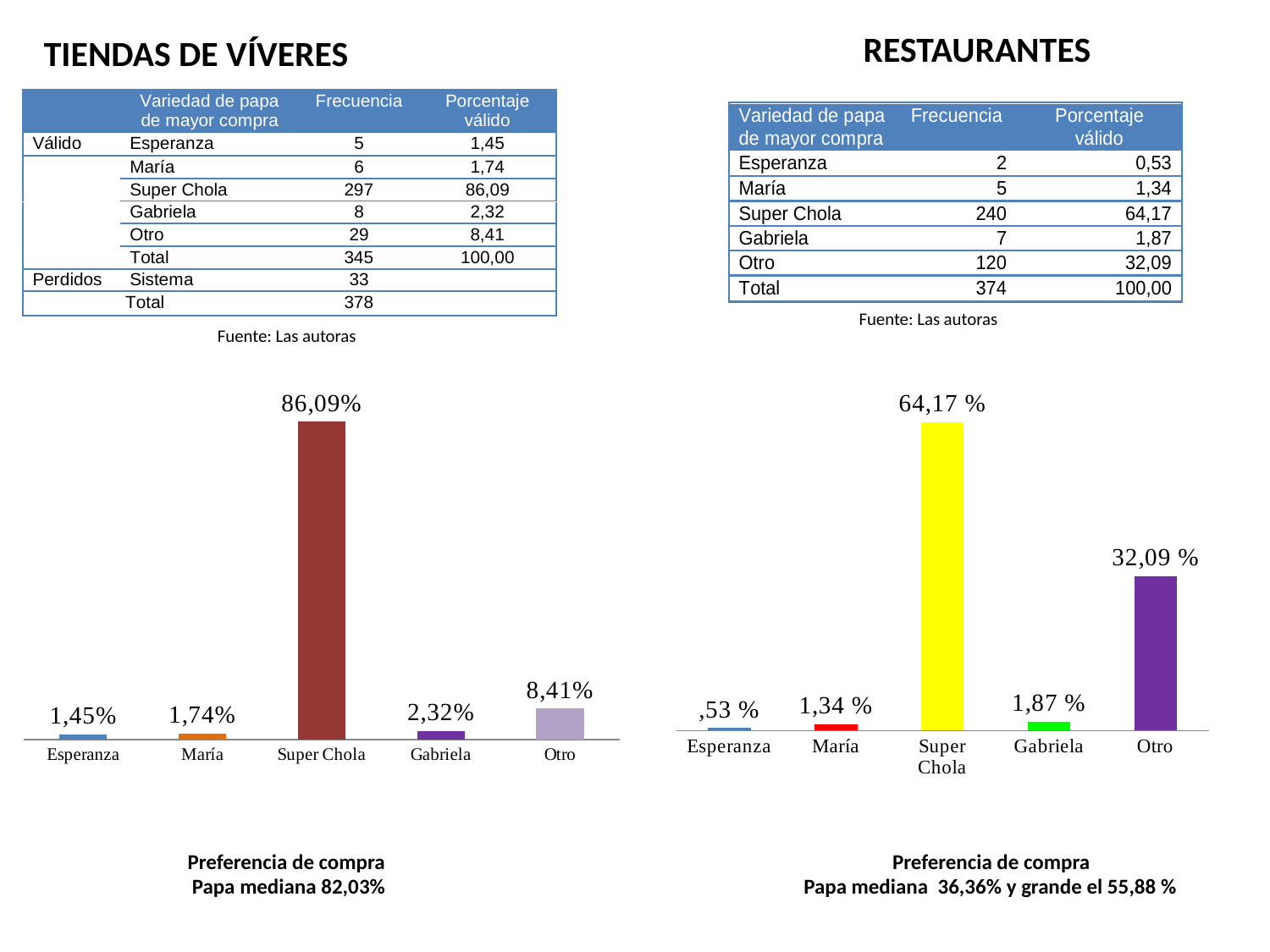
In the chart under TIENDAS DE VÍVERES (left), what is the value for Super Chola? 86,09% In the chart under RESTAURANTES (right), what is the value for Gabriela? 1,87 % In the chart under TIENDAS DE VÍVERES (left), which category has the lowest value? Esperanza What kind of chart is shown under TIENDAS DE VÍVERES (left)? Bar chart In the chart under RESTAURANTES (right), what colour is the bar for Super Chola? Yellow In the chart under TIENDAS DE VÍVERES (left), which is larger, the value for Gabriela or the value for María? Gabriela In the chart under RESTAURANTES (right), what is the difference between the values for Super Chola and Otro? 32,08 % In the chart under RESTAURANTES (right), what is the value for Otro? 32,09 % How many categories are shown in the chart under RESTAURANTES (right)? 5 In the chart under TIENDAS DE VÍVERES (left), what is the difference between the values for Otro and Gabriela? 6,09% In the chart under RESTAURANTES (right), which category has the highest value? Super Chola In the chart under TIENDAS DE VÍVERES (left), what is the value for Otro? 8,41%